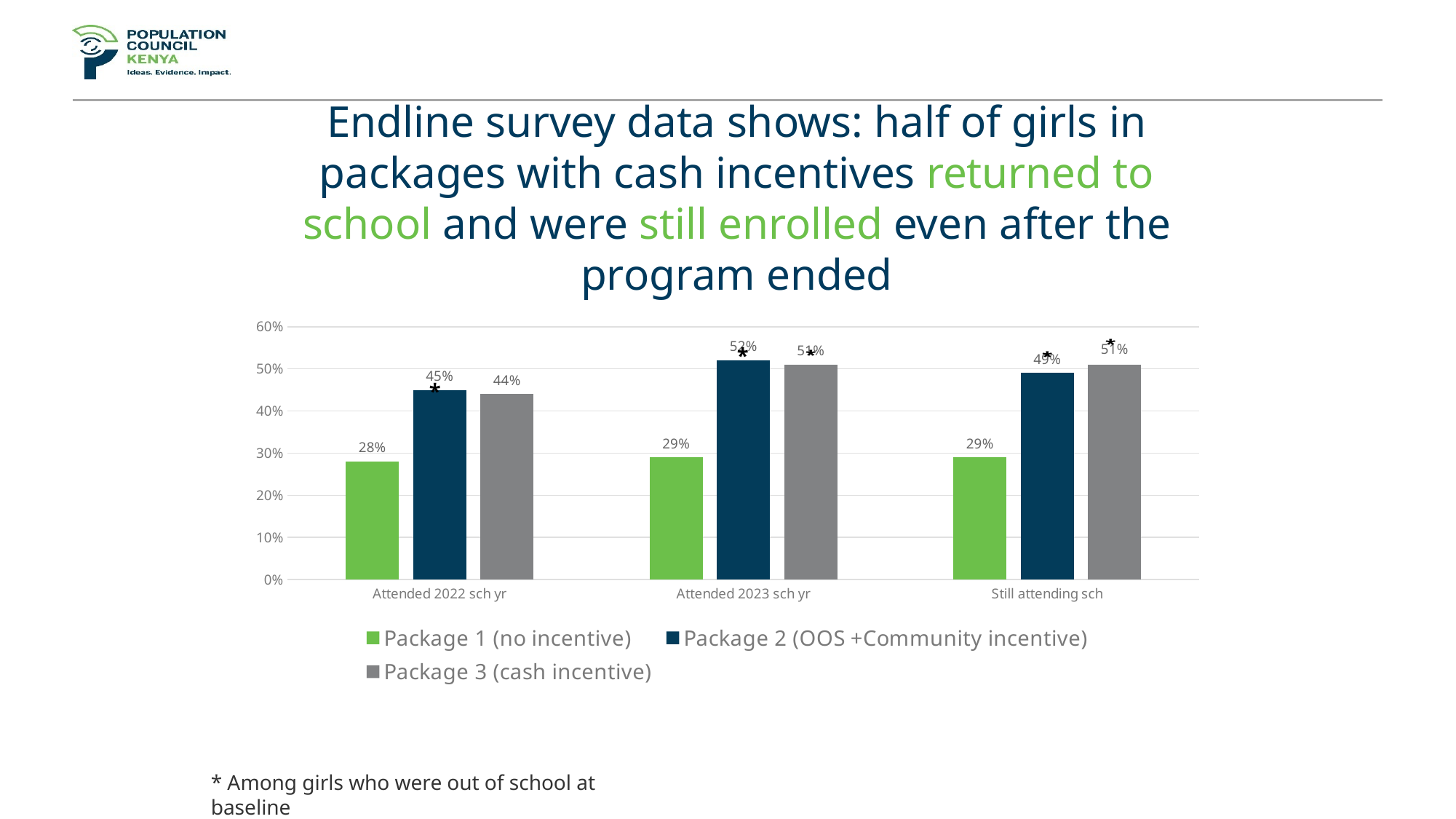
What kind of chart is shown on the slide? bar chart What is the value for Package 1 (no incentive) in the Attended 2022 sch yr category? 28% Is the value for Package 1 (no incentive) in the Attended 2022 sch yr category greater or less than 30%? less What is the value for Package 2 (OOS +Community incentive) in the Attended 2022 sch yr category? 45% How many series does the legend list? 3 What is the value for Package 3 (cash incentive) in the Attended 2022 sch yr category? 44% Which series is shown in green in the chart? Package 1 (no incentive) What is the value for Package 1 (no incentive) in the Attended 2023 sch yr category? 29% Which package has the lowest value in the Still attending sch category? Package 1 (no incentive) How many categories are shown on the x axis? 3 Which package has the highest value in the Attended 2022 sch yr category? Package 2 (OOS +Community incentive) What is the difference between Package 2 (OOS +Community incentive) and Package 1 (no incentive) in the Attended 2022 sch yr category? 17%